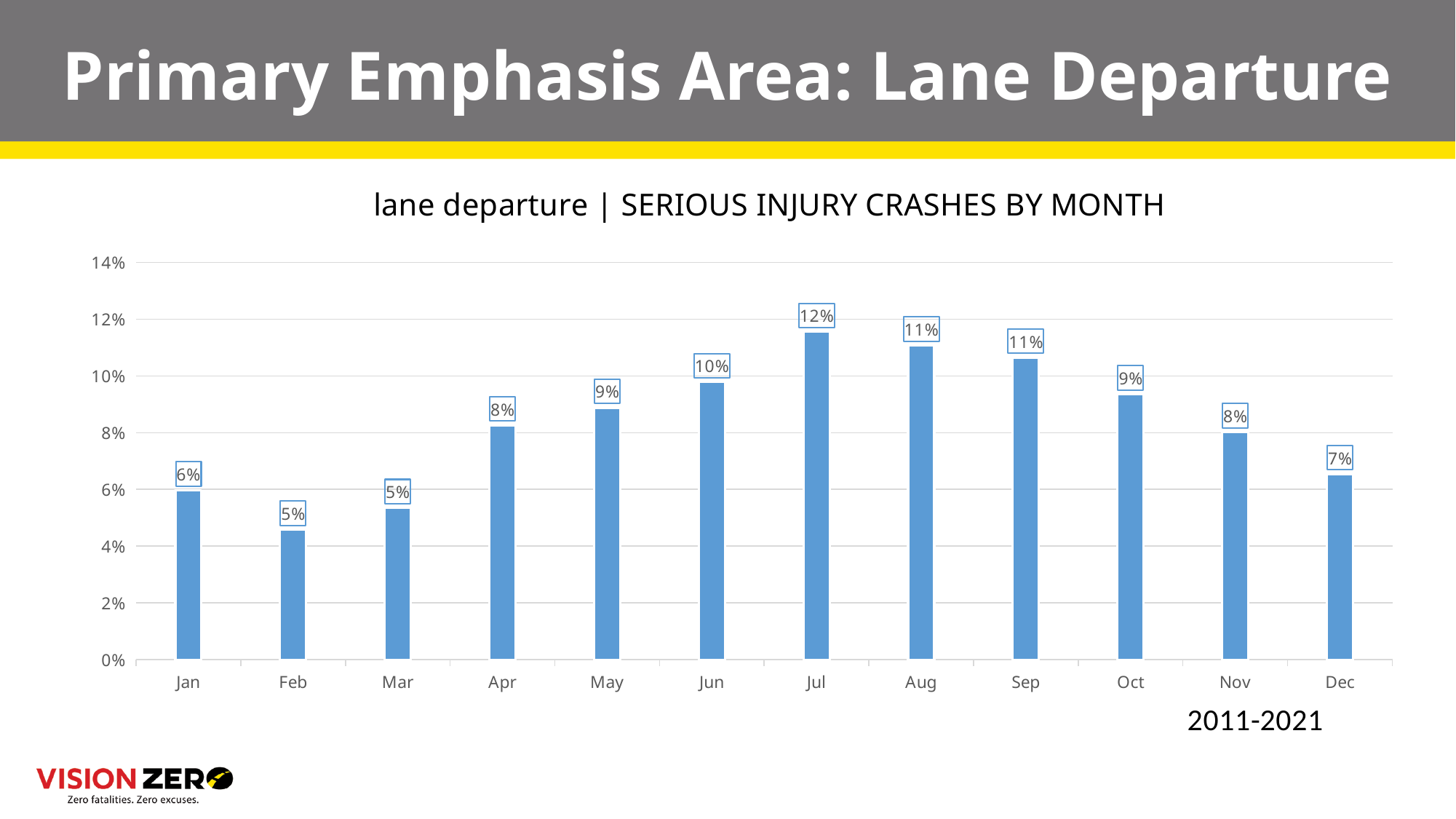
Which month has the highest share of serious injury crashes? Jul Is the value for Jan greater or less than 8%? less What is the value for Feb? 5% Is the value for Jun greater or less than 8%? greater What is the difference between the values for Jul and Jan? 6% Do the values rise or fall from Jul to Dec? fall What is the value for Jul? 12% Which is larger, the value for Jun or the value for Apr? Jun What year range is noted below the chart? 2011-2021 How many months are shown on the x axis? 12 What is the value for Dec? 7% What kind of chart is shown on the slide? bar chart